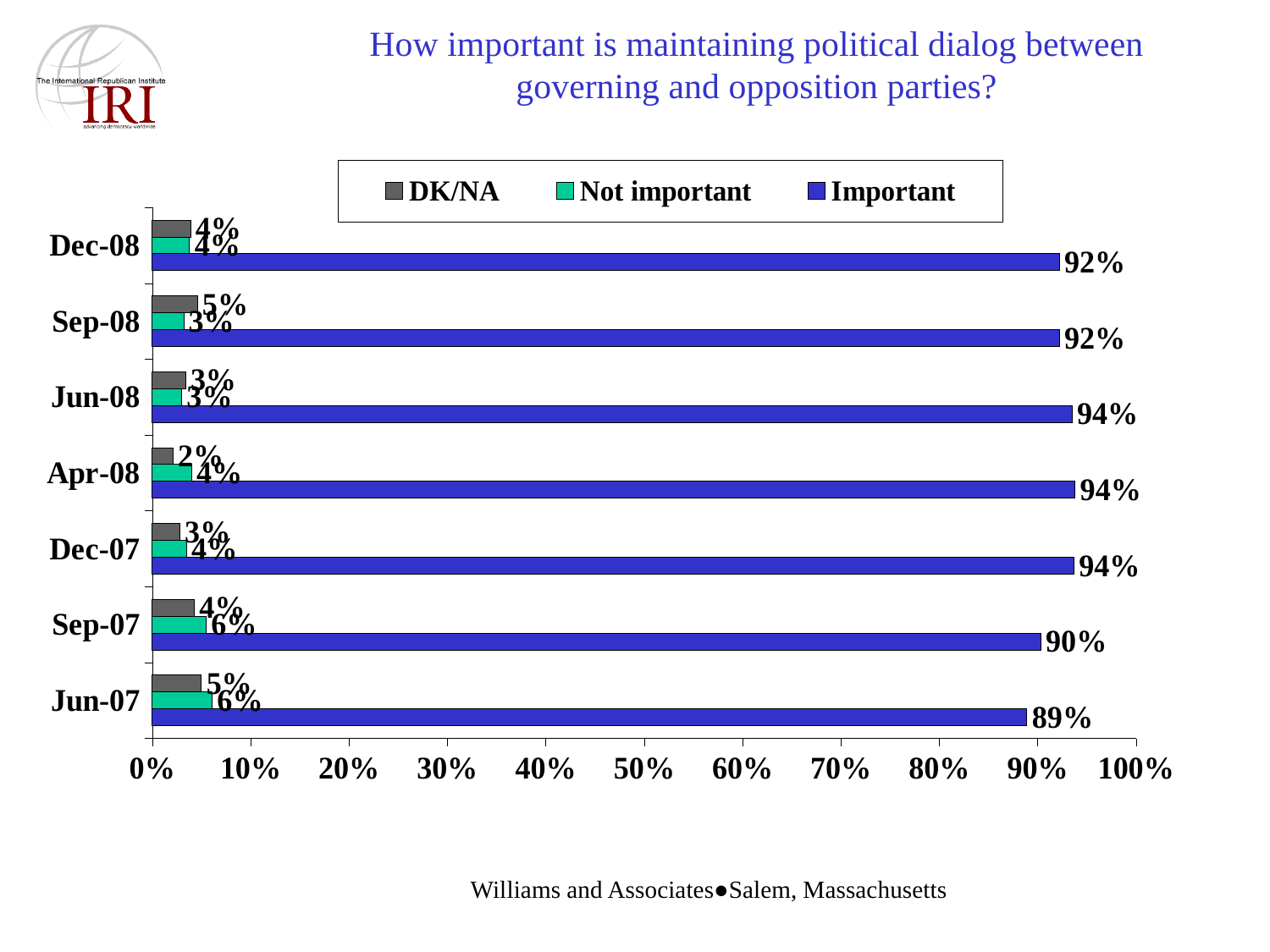
What is the value for Not important in Jun-07? 6% What is the value for Important in Apr-08? 94% What is the value for Important in Jun-07? 89% What kind of chart is shown on the slide? bar chart How many survey periods are shown on the chart? 7 What is the value for Important in Sep-07? 90% Which is larger, the Important value for Sep-07 or for Jun-07? Sep-07 How many series does the legend list? 3 Which survey period has the lowest value for Important? Jun-07 What is the difference between the Important values for Jun-08 and Jun-07? 5 percentage points What is the value for Important in Dec-08? 92% Is the value for Important in Jun-07 greater or less than 80%? greater